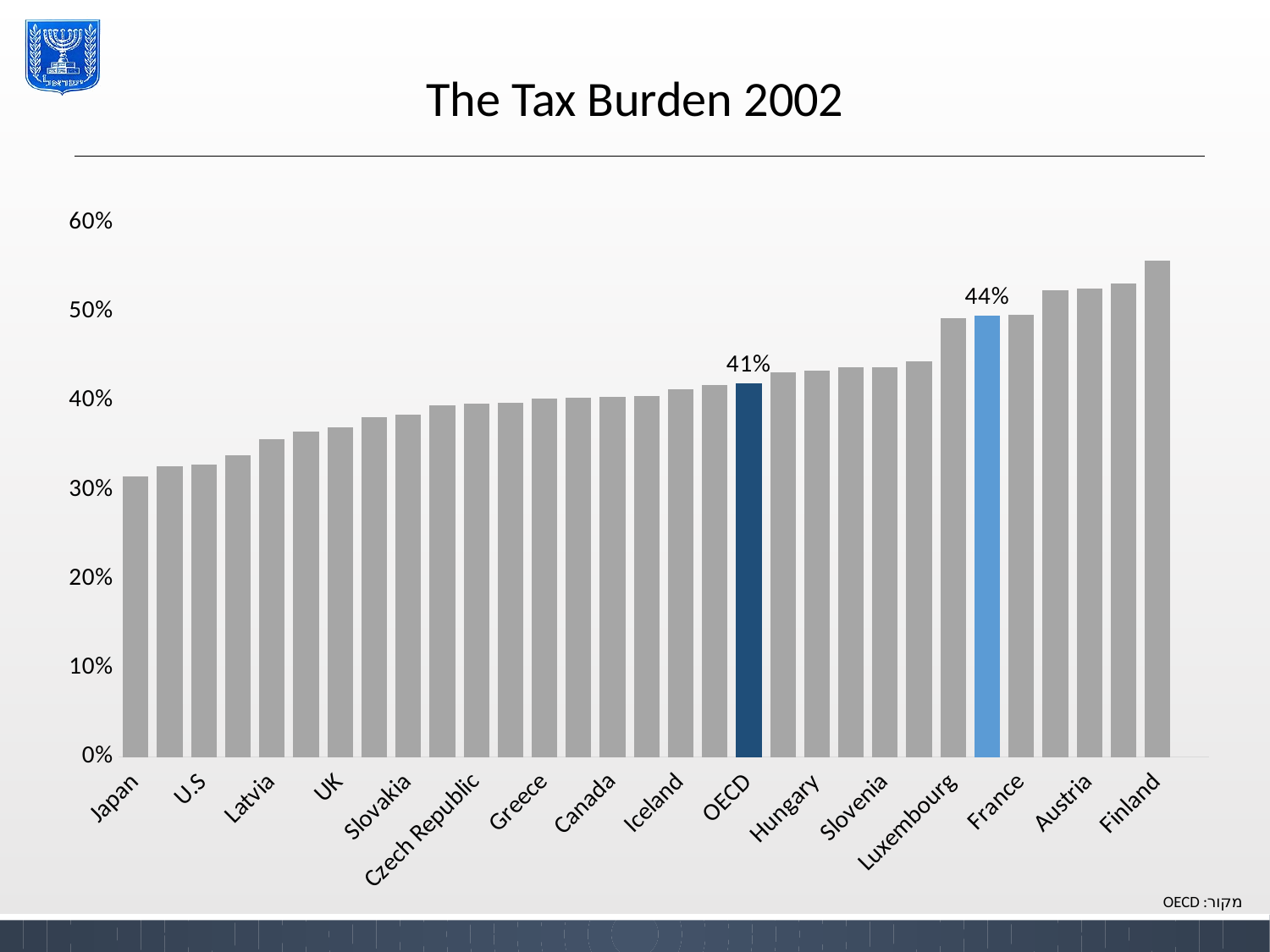
Is the value for Finland greater or less than 50%? greater What is the difference between the light blue bar's value (44%) and the OECD value (41%)? 3 percentage points What colour is the OECD bar? dark blue Is the value for Japan greater or less than 40%? less What is the title of the chart? The Tax Burden 2002 What kind of chart is shown on the slide? bar chart Which labelled country has the lowest bar? Japan Which labelled country has the highest bar? Finland What value is labelled on the light blue bar? 44% Do the bar values rise or fall from left to right along the x axis? rise What is the value shown for OECD? 41% Which is larger, the OECD bar or the light blue bar? the light blue bar